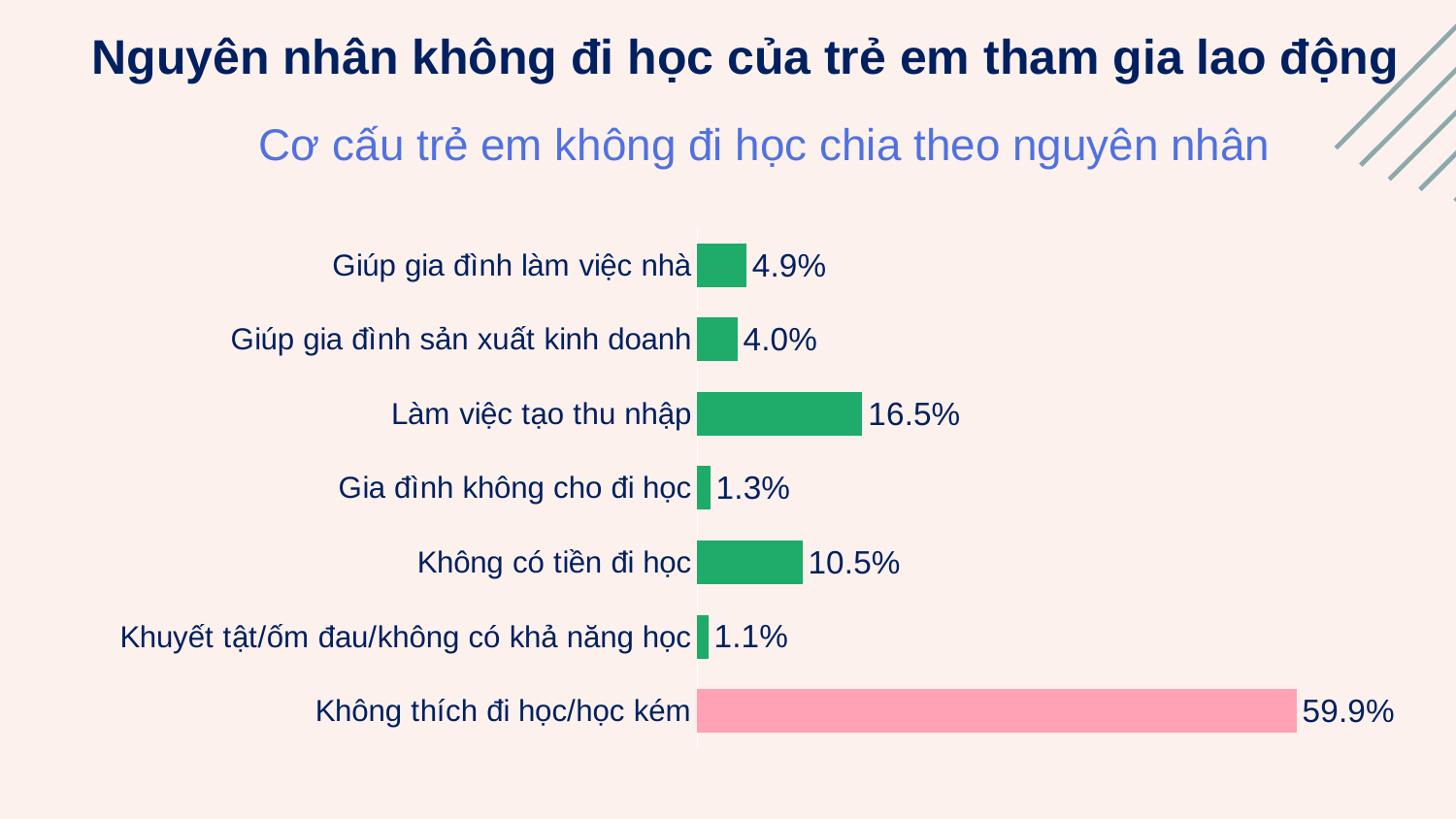
What is the value for "Không có tiền đi học"? 10.5% Which is larger: "Gia đình không cho đi học" or "Không có tiền đi học"? Không có tiền đi học Which category has the lowest value? Khuyết tật/ốm đau/không có khả năng học What is the value for "Giúp gia đình sản xuất kinh doanh"? 4.0% What is the difference between "Giúp gia đình làm việc nhà" and "Giúp gia đình sản xuất kinh doanh"? 0.9% How many categories are shown in the chart? 7 What is the difference between "Làm việc tạo thu nhập" and "Không có tiền đi học"? 6.0% What is the value for "Làm việc tạo thu nhập"? 16.5% What kind of chart is shown on the slide? Bar chart What is the value for "Không thích đi học/học kém"? 59.9% What is the title of the chart? Cơ cấu trẻ em không đi học chia theo nguyên nhân Which category has the highest value? Không thích đi học/học kém